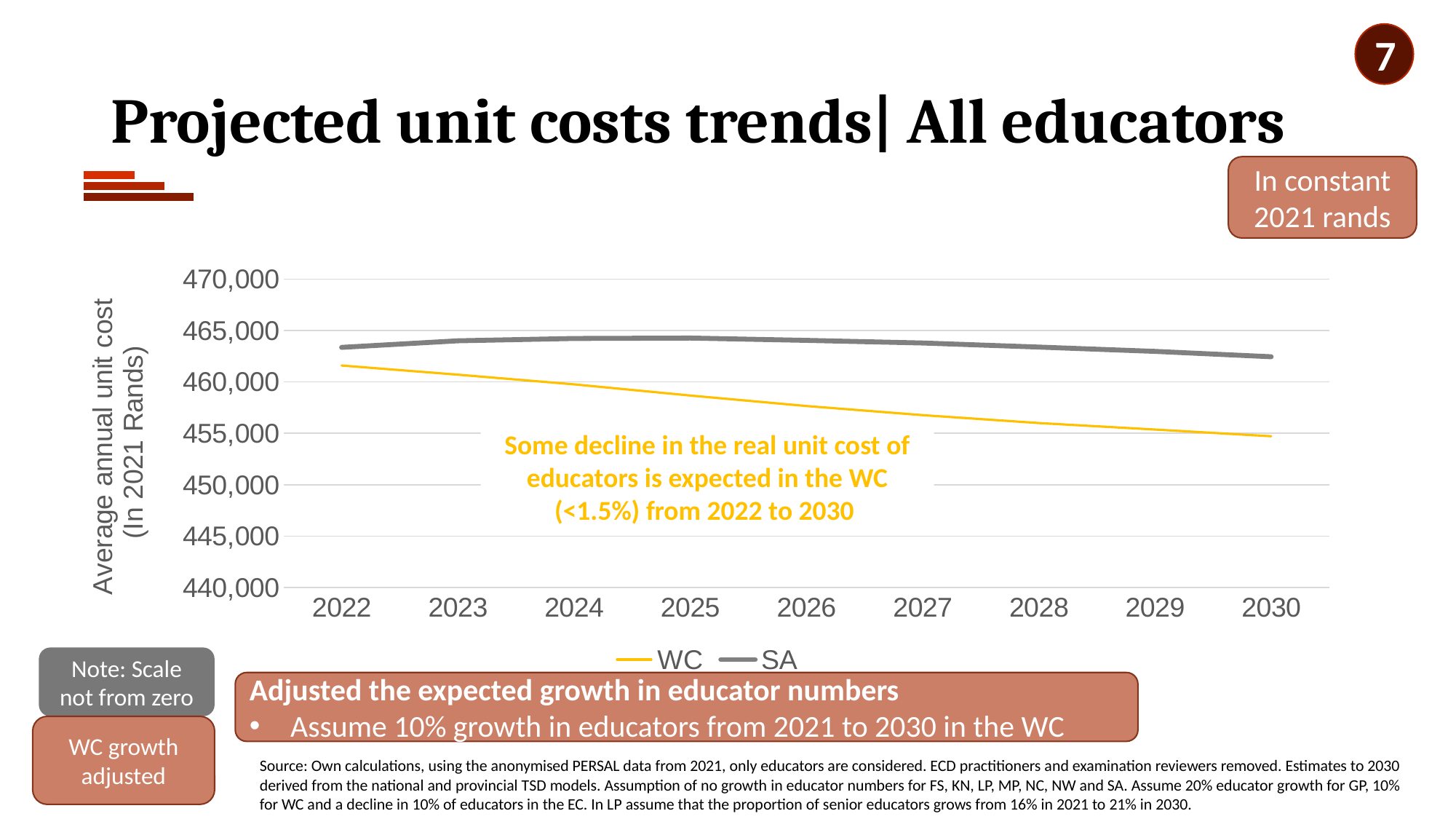
Is the value for SA in 2025 greater or less than 465,000? less How many series does the chart legend list? 2 Is the value for SA in 2030 greater or less than 460,000? greater What is the label on the vertical axis of the chart? Average annual unit cost (In 2021 Rands) Is the value for WC in 2022 greater or less than 460,000? greater In 2030, which series has the lower average annual unit cost, WC or SA? WC In 2022, which series has the higher average annual unit cost, WC or SA? SA What kind of chart is shown on the slide? line chart How many years are plotted along the x axis of the chart? 9 Does the WC line rise or fall from 2022 to 2030? fall Which series is drawn in yellow in the chart? WC